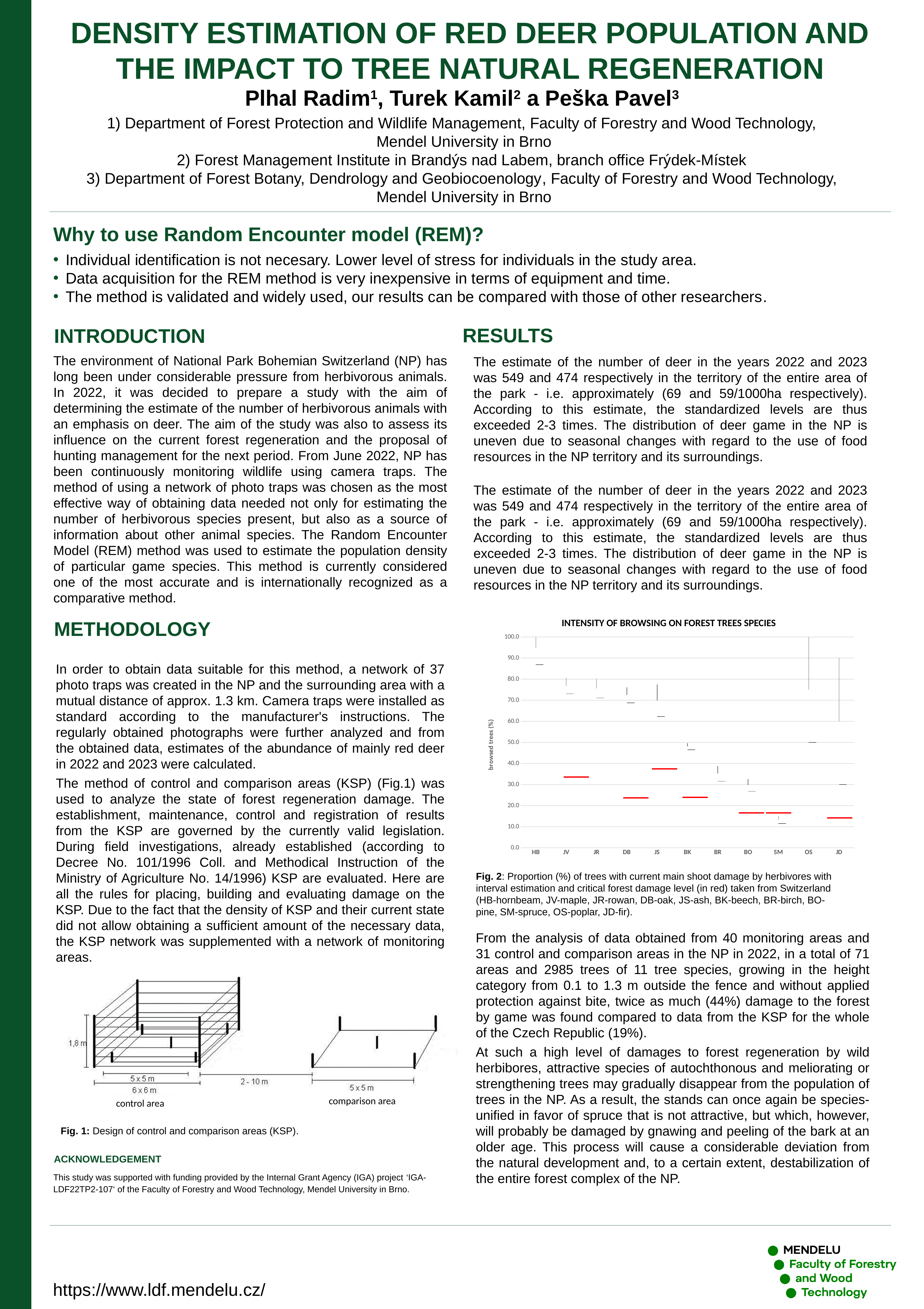
Which has a higher proportion of browsed trees, BR or JS? JS Is the value for JS greater or less than 50? greater Is the value for HB greater or less than 80? greater How many tree species categories are shown on the x axis of the chart? 11 What is the title of the chart? INTENSITY OF BROWSING ON FOREST TREES SPECIES Is the value for BO greater or less than 40? less Which has a higher proportion of browsed trees, JV or BK? JV Which tree species has the lowest proportion of browsed trees in the chart? SM What is the label of the y axis of the chart? browsed trees (%) Which tree species has the highest proportion of browsed trees in the chart? HB Do the plotted values generally rise or fall from HB to SM along the x axis? fall